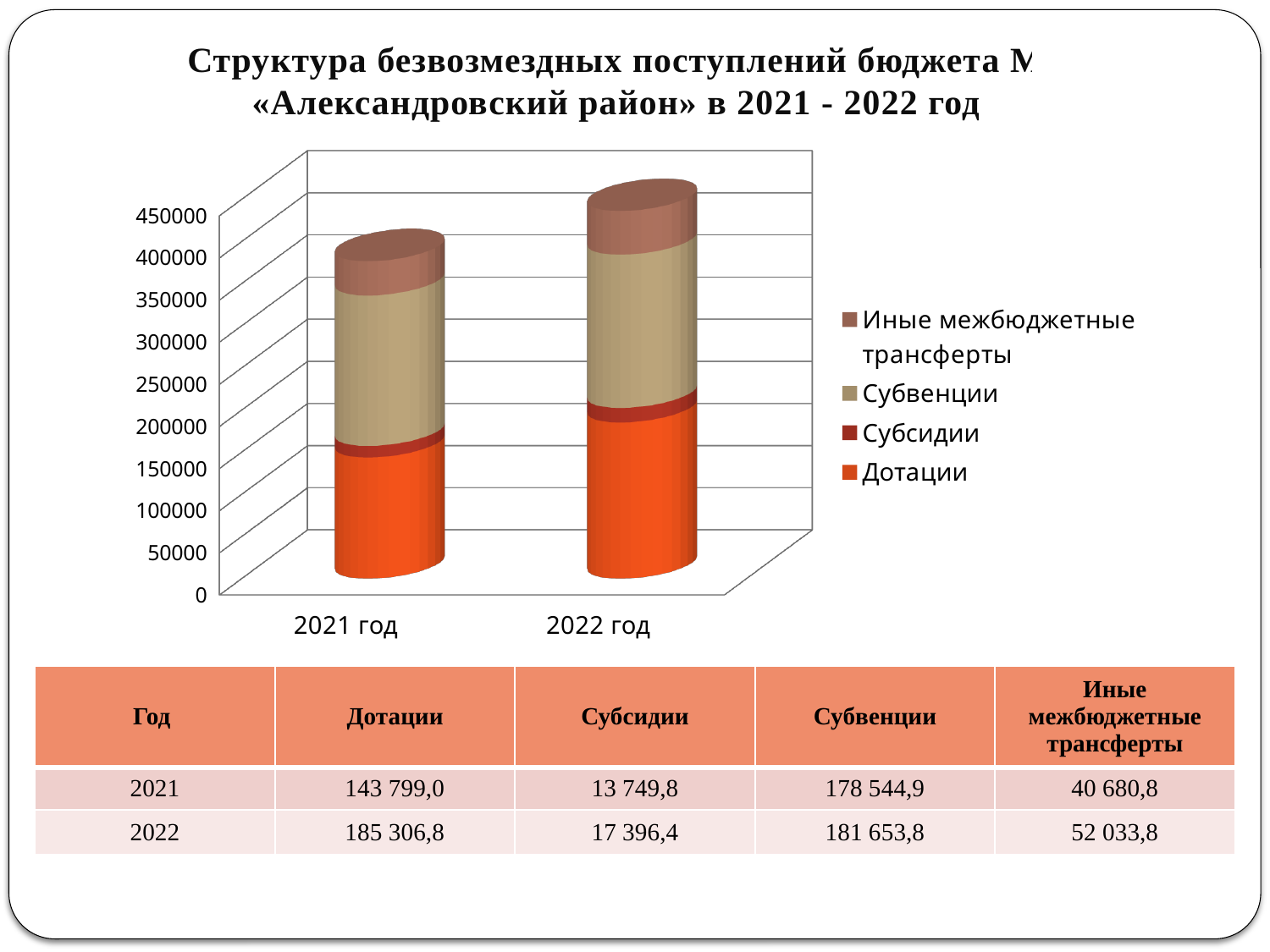
What is the value of Дотации for 2021? 143 799,0 What kind of chart is shown on the slide? Stacked bar chart Which is larger: Субсидии in 2021 or Субсидии in 2022? Субсидии in 2022 Which series has the largest value in 2021? Субвенции What is the value of Субвенции for 2022? 181 653,8 What is the value of Иные межбюджетные трансферты for 2021? 40 680,8 Which series has the smallest value in 2022? Субсидии Is the total height of the 2021 bar greater or less than 400000? less By how much did Дотации increase from 2021 to 2022? 41 507,8 What is the total of the stacked bar for 2022? 436 390,8 How many series does the chart legend list? 4 How many categories (years) are plotted on the x axis of the chart? 2